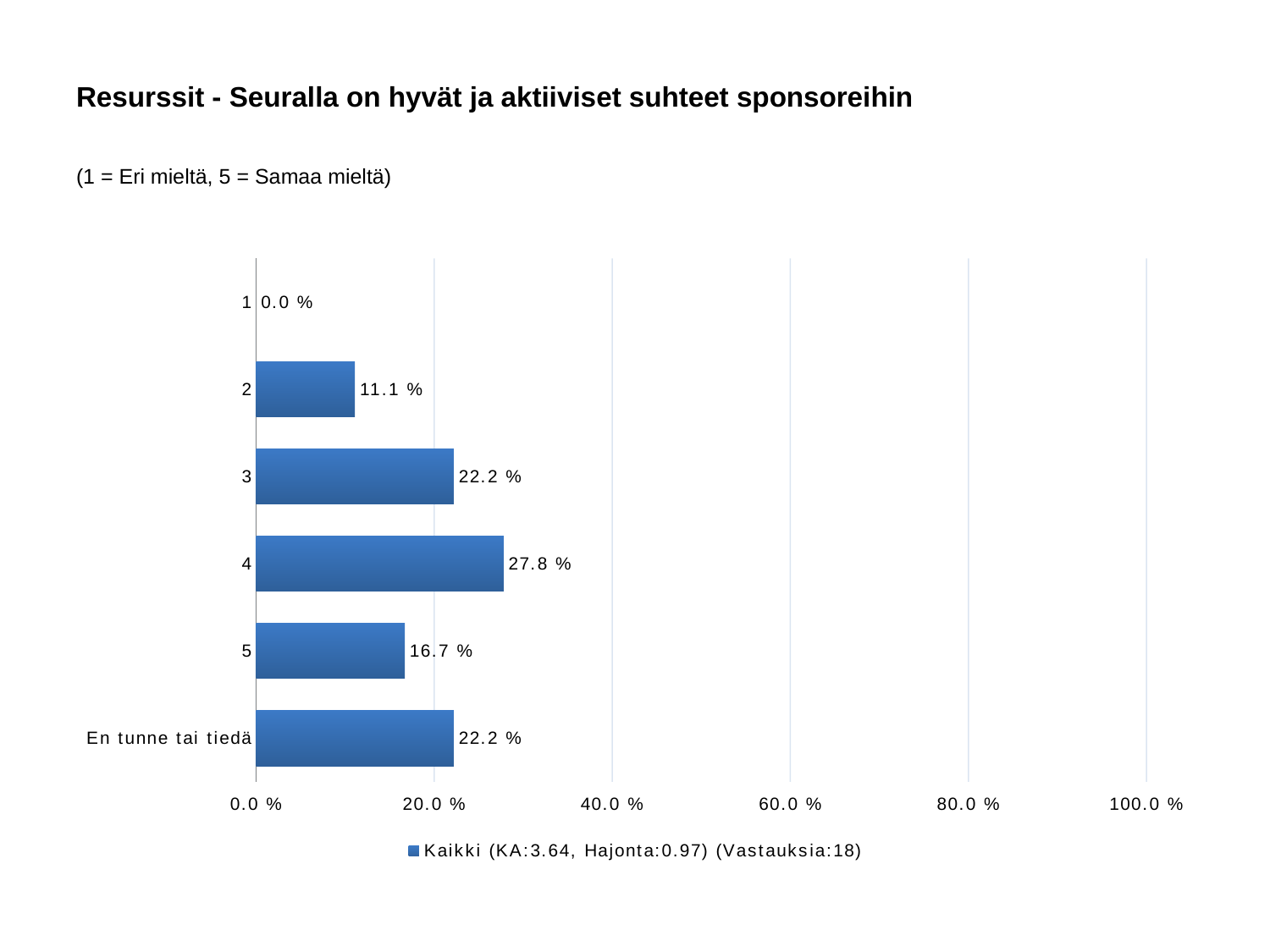
What is the value for category 4? 27.8 % Which category has the highest value? 4 What is the value for category 1? 0.0 % How many series does the legend list? 1 What is the value for 'En tunne tai tiedä'? 22.2 % Which category has the lowest value? 1 How many categories are shown on the chart? 6 What is the value for category 2? 11.1 % What kind of chart is shown? bar chart Which is larger, the value for category 3 or the value for category 5? 3 What is the difference between the values for category 4 and category 5? 11.1 % Is the value for category 4 greater or less than 20.0 %? greater